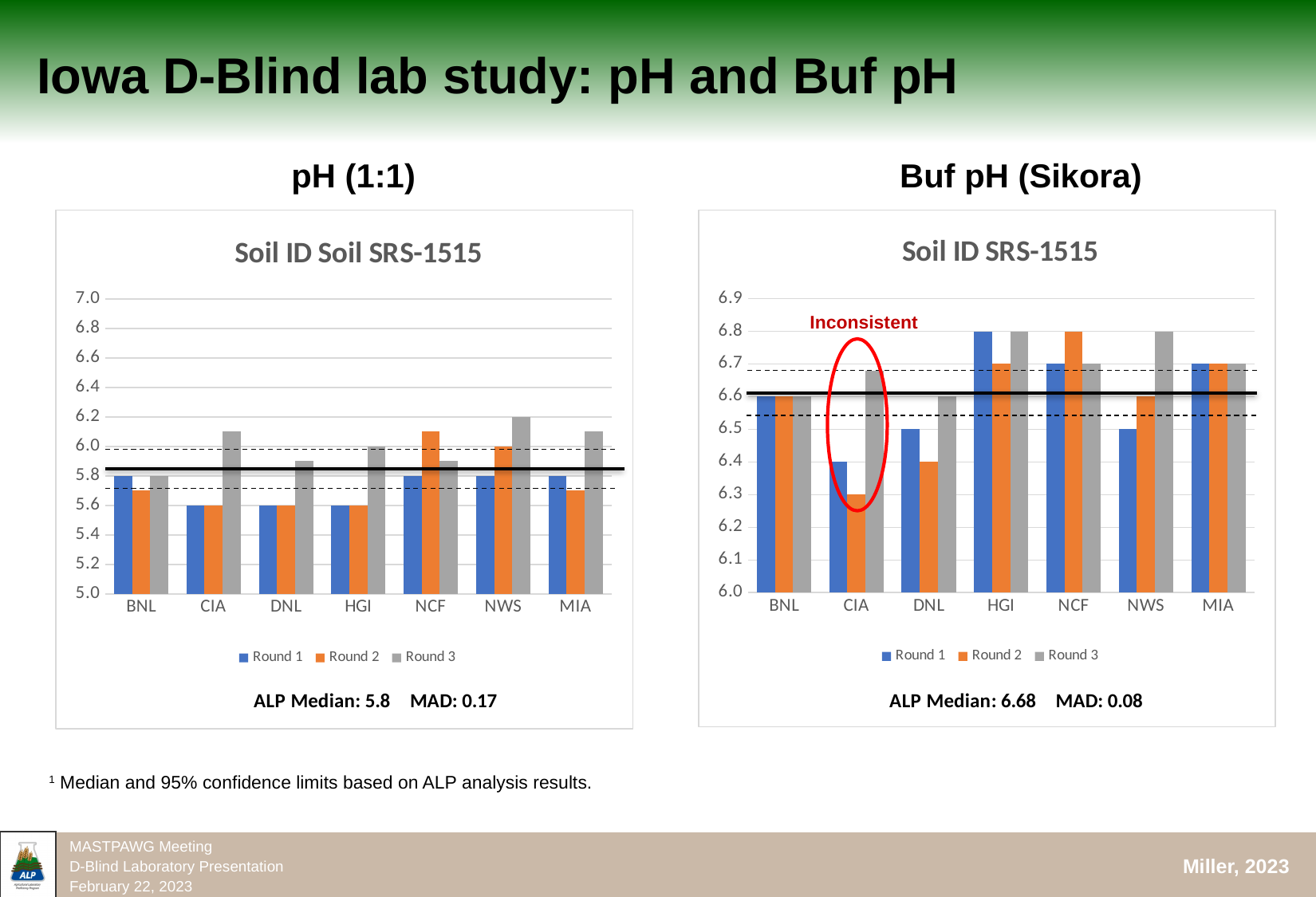
What kind of chart is the pH (1:1) chart on the left? bar chart In the Buf pH (Sikora) chart, is the Round 1 value for DNL greater or less than 6.6? less In the Buf pH (Sikora) chart, which lab has the lowest Round 2 value? CIA What ALP Median is printed below the Buf pH (Sikora) chart? 6.68 In the pH (1:1) chart, is the Round 1 value for CIA greater or less than 5.8? less How many series does the legend of the Buf pH (Sikora) chart list? 3 In the Buf pH (Sikora) chart, which is larger for NWS: the Round 1 value or the Round 3 value? Round 3 In the pH (1:1) chart, which is larger for HGI: the Round 1 value or the Round 3 value? Round 3 Which lab is circled and labelled 'Inconsistent' in the Buf pH (Sikora) chart? CIA How many lab categories are shown on the x axis of the pH (1:1) chart? 7 In the pH (1:1) chart, which lab has the highest Round 3 value? NWS In the pH (1:1) chart, is the Round 2 value for NCF greater or less than 6.0? greater